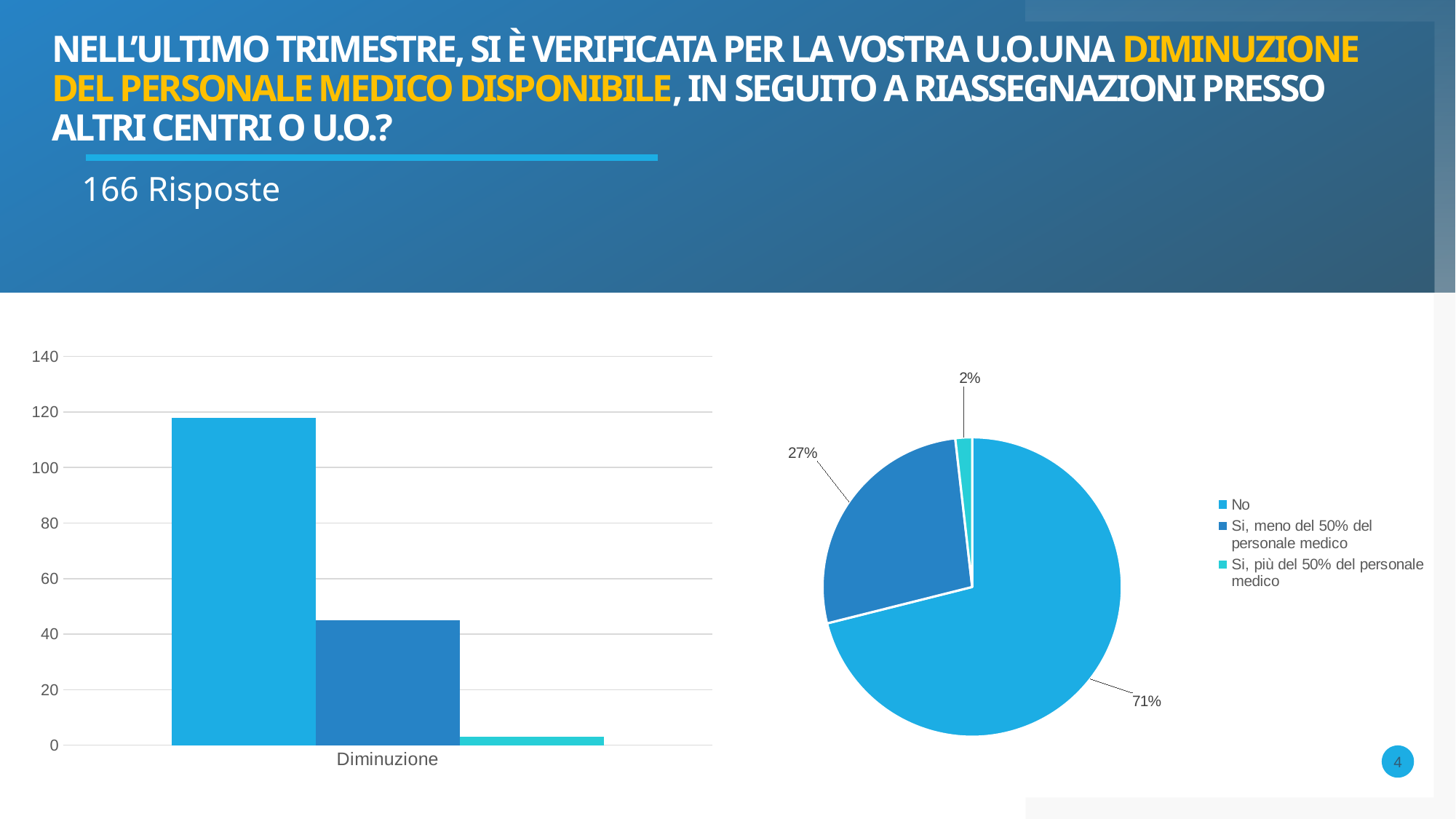
What is the category label shown on the x axis of the bar chart on the left? Diminuzione In the pie chart on the right, what share of responses is 'Si, più del 50% del personale medico'? 2% In the pie chart on the right, which category has the largest share? No In the pie chart on the right, which is larger: the share for 'Si, meno del 50% del personale medico' or the share for 'Si, più del 50% del personale medico'? Si, meno del 50% del personale medico In the pie chart on the right, what share of responses is 'Si, meno del 50% del personale medico'? 27% In the pie chart on the right, what share of responses is 'No'? 71% What kind of chart is shown on the left of the slide? Bar chart In the bar chart on the left, is the value of the tallest bar greater or less than 100? greater In the pie chart on the right, how many percentage points larger is the 'No' share than the 'Si, meno del 50% del personale medico' share? 44 How many entries does the legend of the pie chart on the right list? 3 In the pie chart on the right, which category has the smallest share? Si, più del 50% del personale medico In the bar chart on the left, is the value of the middle (dark blue) bar greater or less than 60? less